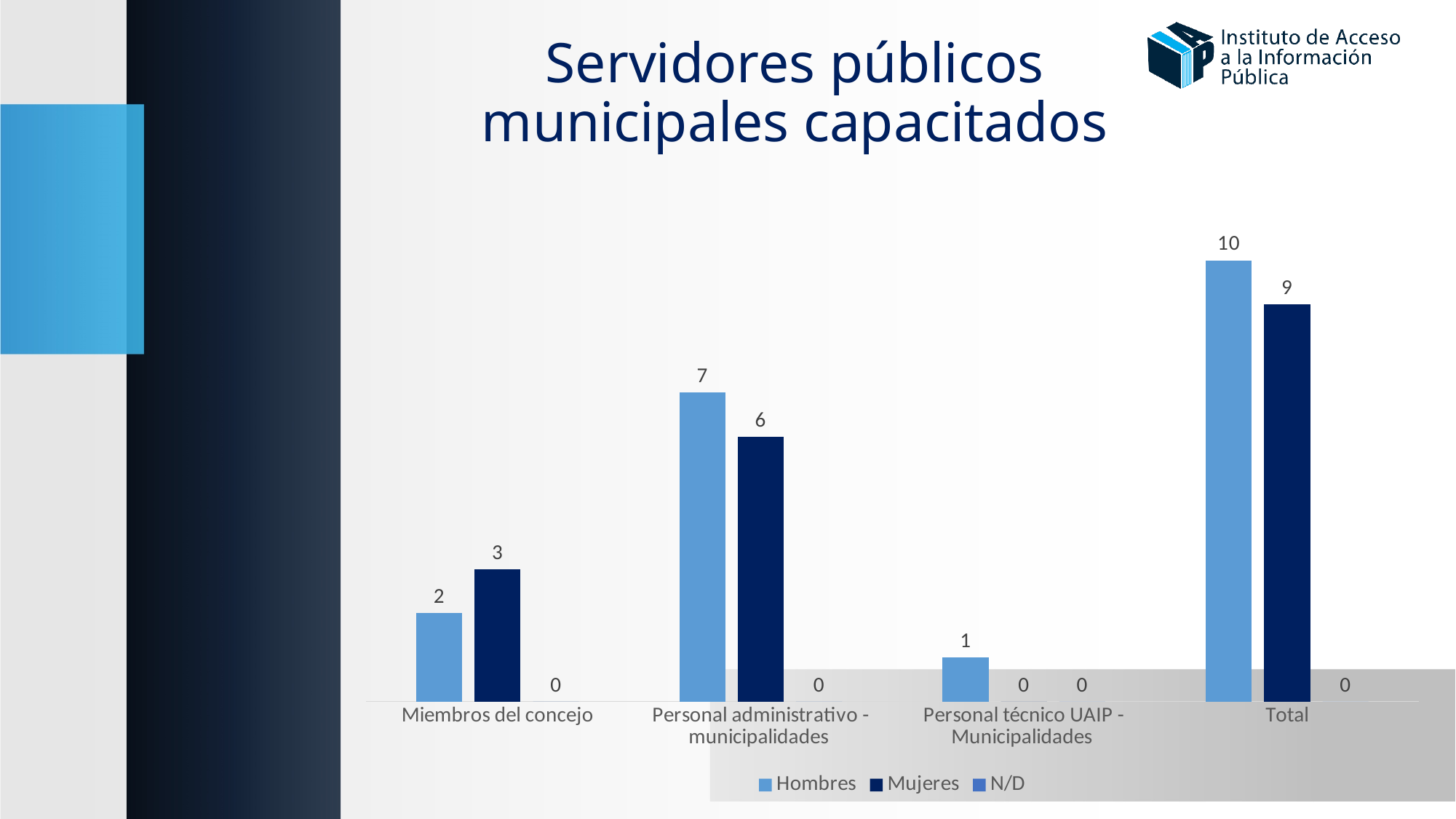
What is the value for Hombres in the Total category? 10 What is the title of the chart on the slide? Servidores públicos municipales capacitados How many series does the legend list? 3 What is the value for Mujeres in the Personal técnico UAIP - Municipalidades category? 0 Which category has the highest value for Mujeres? Total What is the value for Hombres in the Personal administrativo - municipalidades category? 7 Which is larger in the Miembros del concejo category, Hombres or Mujeres? Mujeres What kind of chart is shown on the slide? Bar chart How many categories are shown on the x axis? 4 What is the difference between Hombres and Mujeres in the Total category? 1 Excluding Total, which category has the lowest value for Hombres? Personal técnico UAIP - Municipalidades What is the value for Mujeres in the Miembros del concejo category? 3